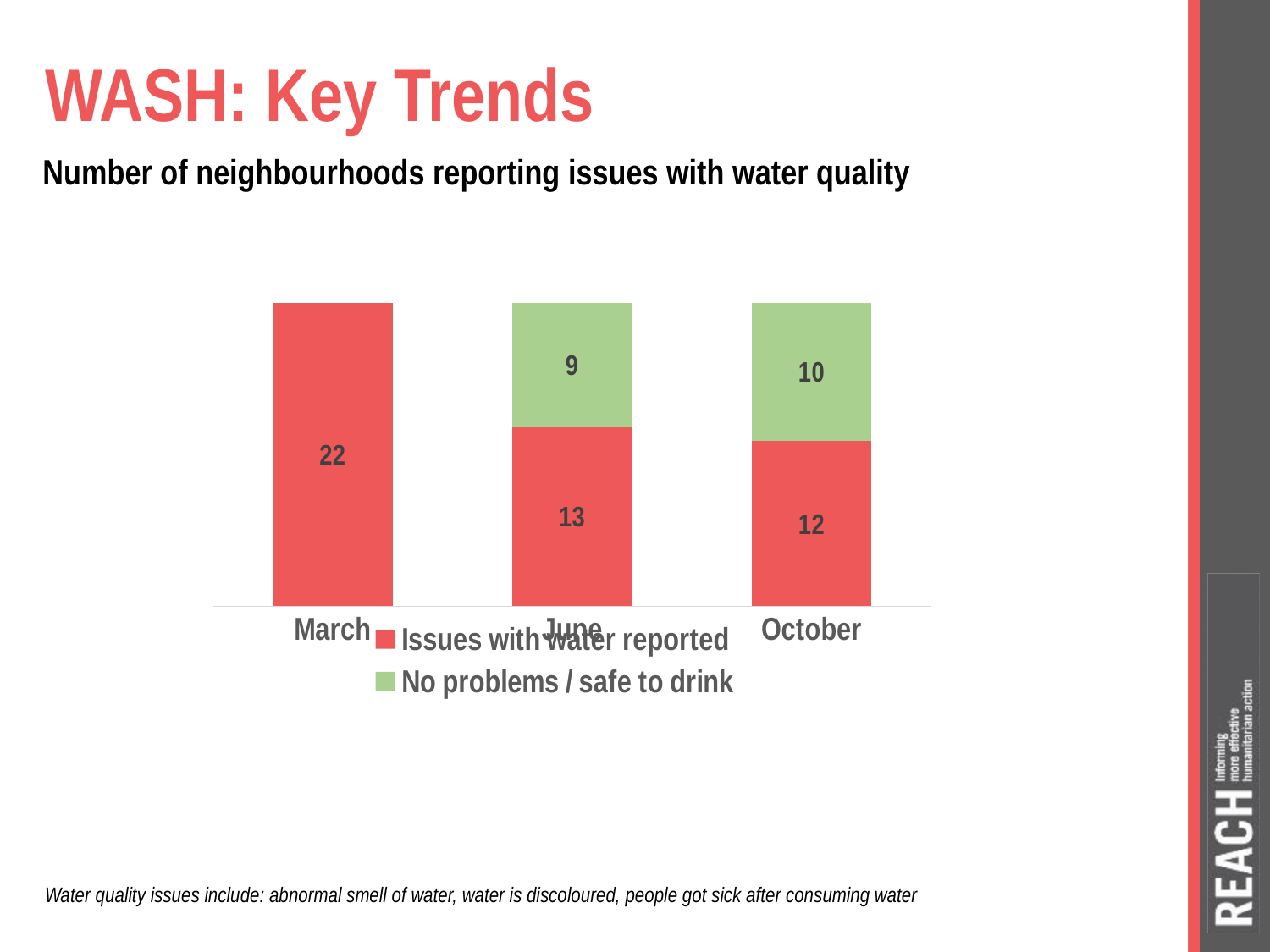
How many months are shown on the x axis of the chart? 3 Which is larger: the number of neighbourhoods reporting no problems in June or in October? October What is the difference between the number of neighbourhoods reporting issues with water in March and in June? 9 How many neighbourhoods reported no problems / safe to drink in June? 9 In which month was the number of neighbourhoods reporting issues with water lowest? October How many neighbourhoods reported issues with water in June? 13 What kind of chart is shown on the slide? Stacked bar chart How many neighbourhoods reported no problems / safe to drink in October? 10 How many series does the legend list? 2 How many neighbourhoods reported issues with water in March? 22 What is the total number of neighbourhoods shown in the June bar? 22 In which month was the number of neighbourhoods reporting issues with water highest? March